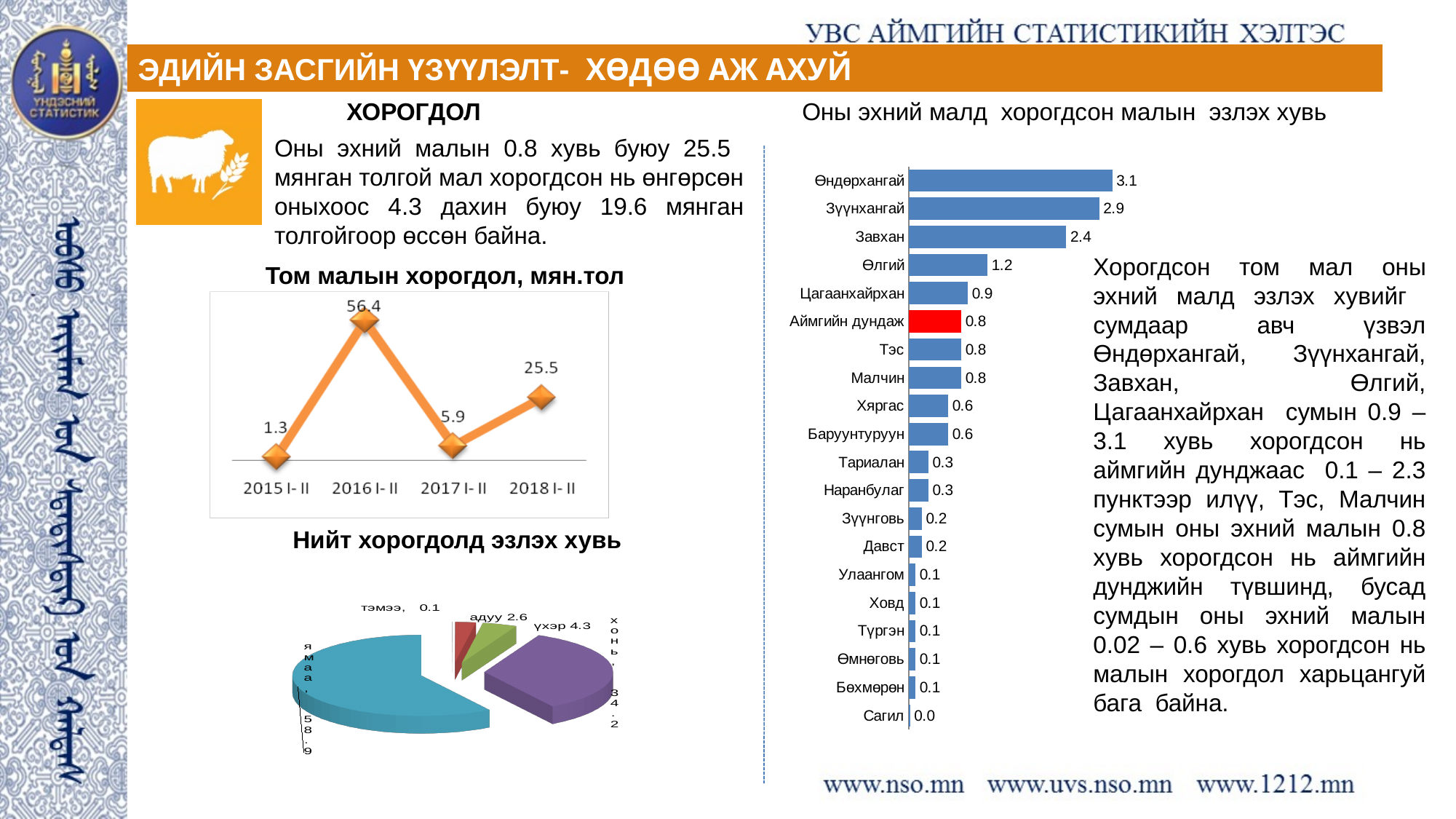
In the chart 'Том малын хорогдол, мян.тол', what is the difference between the 2018 I-II and 2017 I-II values? 19.6 In the chart 'Оны эхний малд хорогдсон малын эзлэх хувь', which is larger: Өлгий or Цагаанхайрхан? Өлгий In the chart 'Оны эхний малд хорогдсон малын эзлэх хувь', what is the difference between Өндөрхангай and Аймгийн дундаж? 2.3 In the chart 'Том малын хорогдол, мян.тол', which period has the lowest value? 2015 I-II How many slices does the pie chart 'Нийт хорогдолд эзлэх хувь' have? 5 In the chart 'Нийт хорогдолд эзлэх хувь', what is the value for ямаа? 58.9 In the chart 'Нийт хорогдолд эзлэх хувь', which category has the smallest slice? тэмээ In the chart 'Оны эхний малд хорогдсон малын эзлэх хувь', which category has the highest value? Өндөрхангай What kind of chart is 'Том малын хорогдол, мян.тол'? line chart In the chart 'Том малын хорогдол, мян.тол', what is the value for 2016 I-II? 56.4 In the chart 'Оны эхний малд хорогдсон малын эзлэх хувь', what is the value for Завхан? 2.4 In the chart 'Оны эхний малд хорогдсон малын эзлэх хувь', which bar is coloured red? Аймгийн дундаж